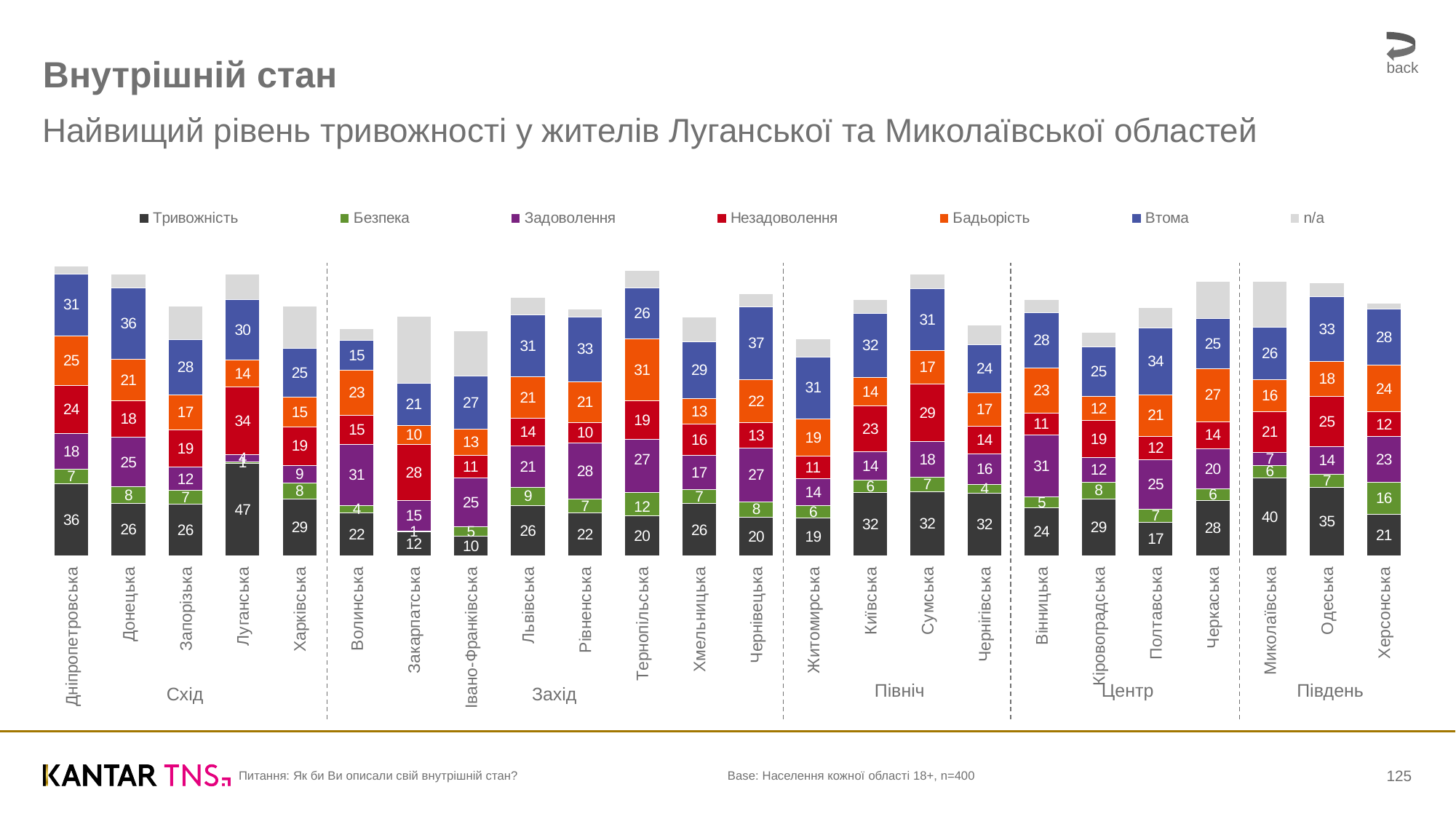
What is the Бадьорість value for Тернопільська? 31 What is the Задоволення value for Вінницька? 31 Which region has the highest Тривожність value? Луганська How many regions are shown on the x axis? 24 Which region has the lowest Тривожність value? Івано-Франківська Which has the larger Втома value, Чернівецька or Одеська? Чернівецька What is the difference between the Тривожність values for Луганська and Миколаївська? 7 What is the Тривожність value for Луганська? 47 What is the Втома value for Донецька? 36 What is the Незадоволення value for Закарпатська? 28 What kind of chart is shown on the slide? Stacked bar chart How many series does the legend list? 7